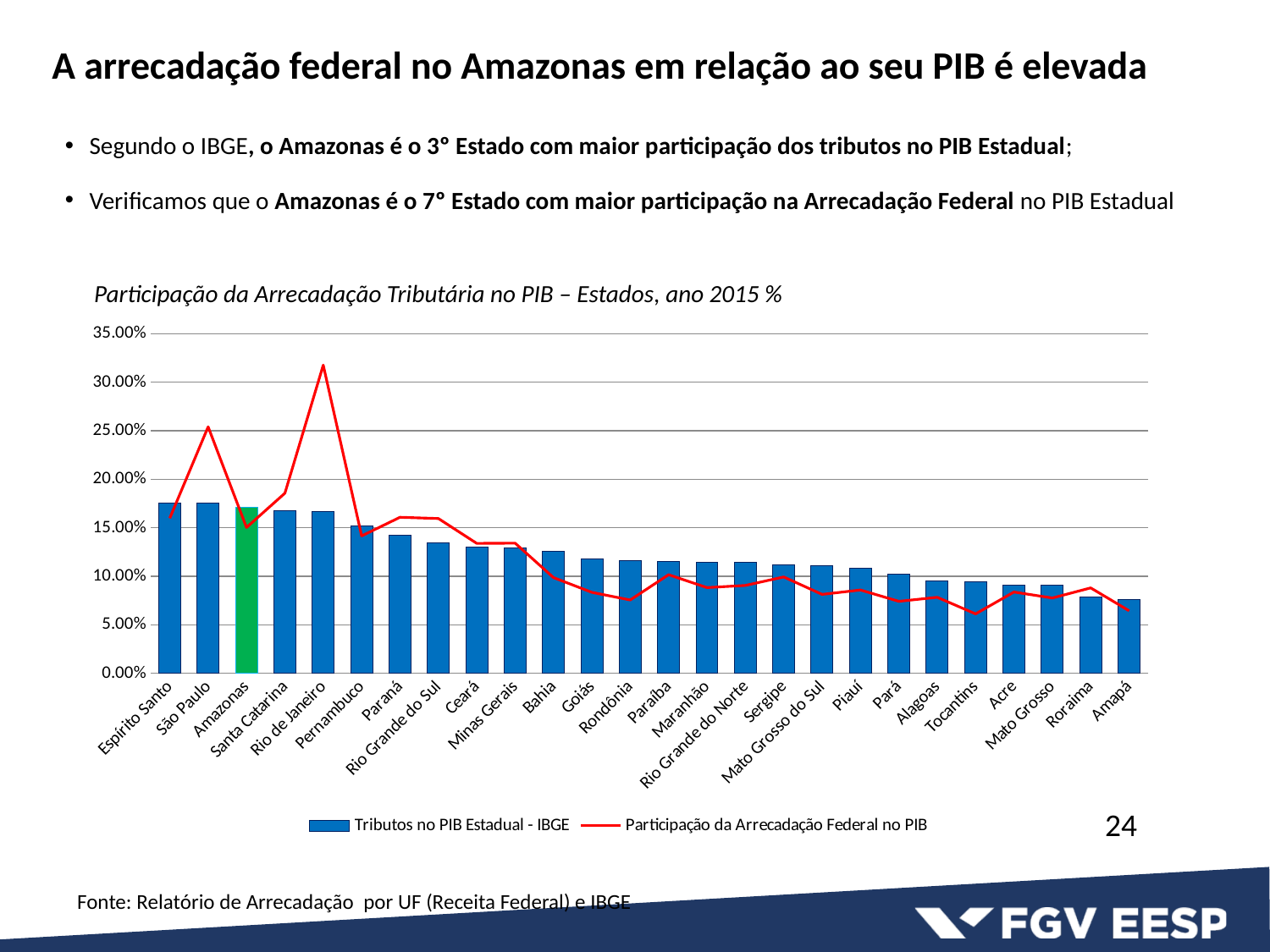
How many states are shown along the x axis of the chart? 26 What kind of chart is shown on the slide? A combined bar and line chart Which state's bar is highlighted in green in the chart? Amazonas Which state has the highest value on the red line (Participação da Arrecadação Federal no PIB)? Rio de Janeiro What is the title of the chart? Participação da Arrecadação Tributária no PIB – Estados, ano 2015 % For Rio de Janeiro, which is larger: the Tributos no PIB Estadual - IBGE bar or the Participação da Arrecadação Federal no PIB line value? Participação da Arrecadação Federal no PIB Is the Participação da Arrecadação Federal no PIB value for Rio de Janeiro greater or less than 30.00%? greater Is the Tributos no PIB Estadual - IBGE bar for Espírito Santo greater or less than 15.00%? greater Do the Tributos no PIB Estadual - IBGE bars generally rise or fall from left to right along the x axis? fall How many series does the chart legend list? 2 Is the Tributos no PIB Estadual - IBGE bar for Amapá greater or less than 10.00%? less